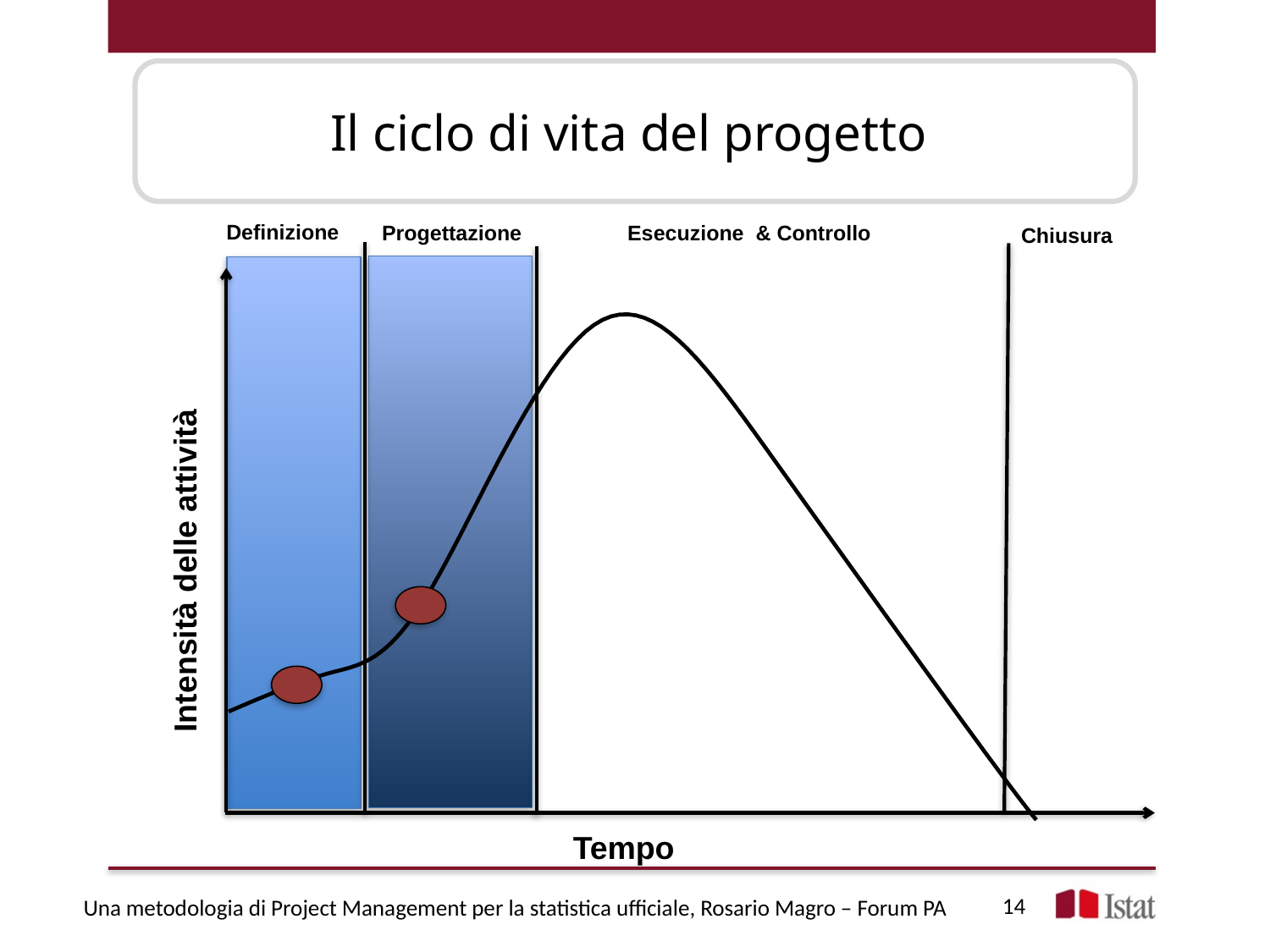
Does the curve rise or fall as it approaches the Chiusura phase? fall What is the label of the vertical axis? Intensità delle attività What kind of chart is shown on the slide? line chart Which phase shows the lowest intensity of activities at the start of the curve? Definizione Does the curve rise or fall during the Progettazione phase? rise How many project phases are labelled along the top of the chart? 4 Is the intensity of activities higher in the Definizione phase or in the Esecuzione & Controllo phase? Esecuzione & Controllo What is the label of the horizontal axis? Tempo Does the curve rise or fall overall from the start of the Definizione phase to the end of the Progettazione phase? rise In which phase does the curve reach its highest point? Esecuzione & Controllo